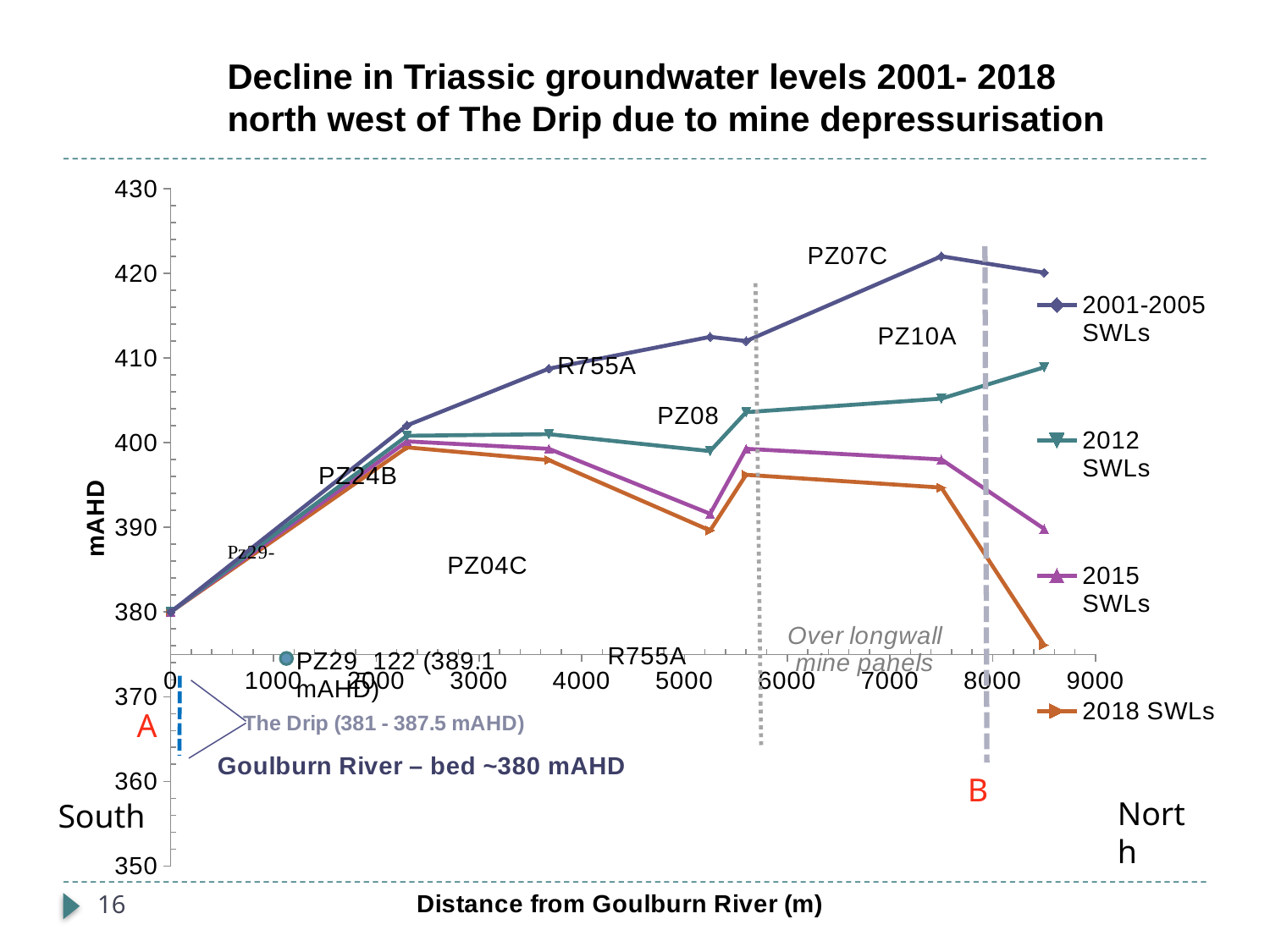
What is the title of the x axis? Distance from Goulburn River (m) How many series does the legend list? 4 What is the value of the 2001-2005 SWLs series at 0 m from the Goulburn River? 380 Is the value of the 2001-2005 SWLs series at about 7500 m greater or less than 410? greater What kind of chart is shown on the slide? line chart What are the series names listed in the legend? 2001-2005 SWLs, 2012 SWLs, 2015 SWLs, 2018 SWLs Which series has the highest values across the chart? 2001-2005 SWLs Is the value of the 2012 SWLs series at its far-right point (about 8500 m) greater or less than 400? greater Does the 2018 SWLs series rise or fall between about 7500 m and 8500 m? fall At the far-right point (about 8500 m), which series is higher: 2001-2005 SWLs or 2018 SWLs? 2001-2005 SWLs Is the value of the 2018 SWLs series at its far-right point (about 8500 m) greater or less than 380? less Which series has the lowest value at the far-right point (about 8500 m)? 2018 SWLs